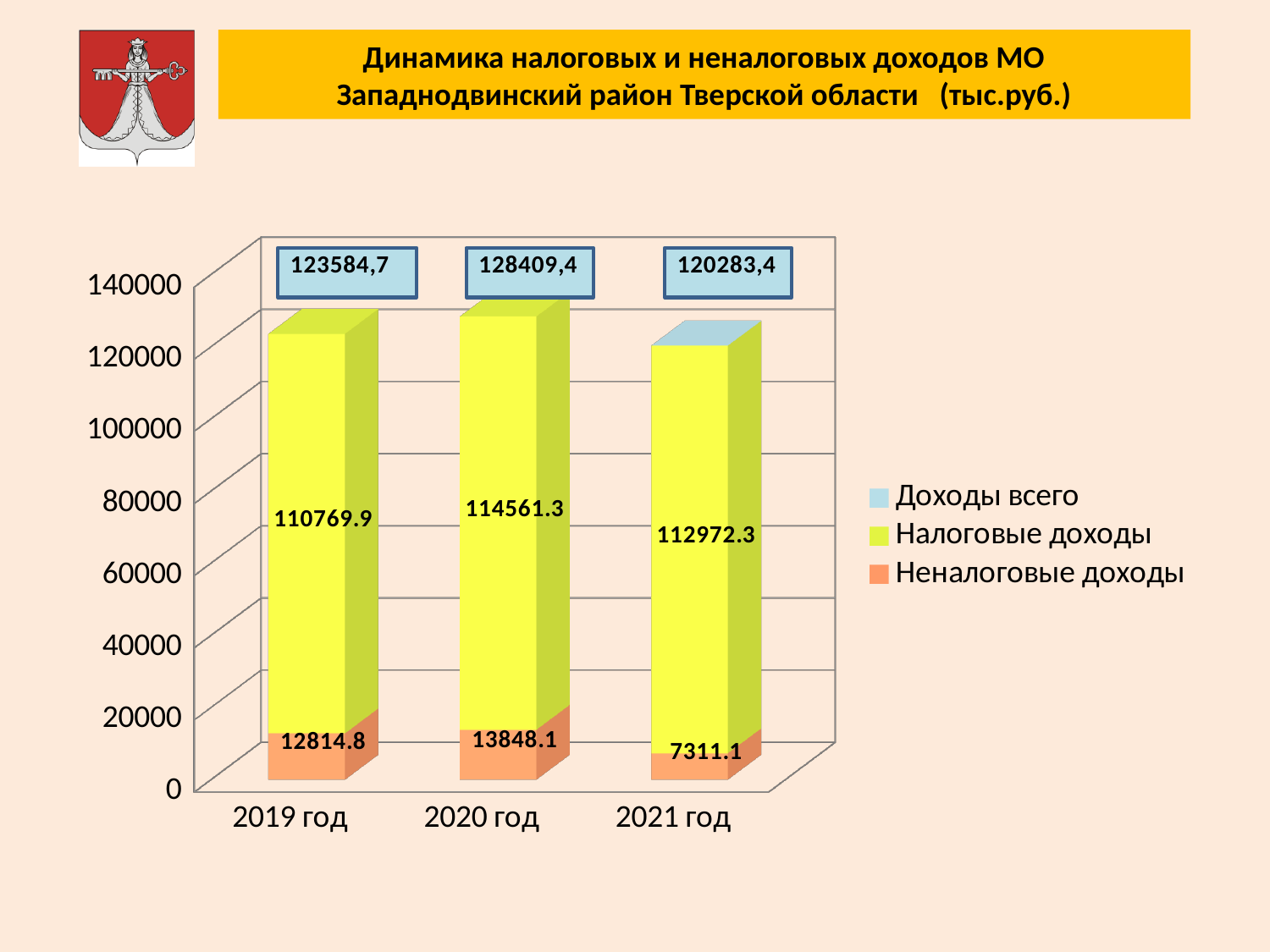
Which year has the lowest Неналоговые доходы? 2021 год What is the value of Налоговые доходы for 2020 год? 114561.3 What is the value of Неналоговые доходы for 2021 год? 7311.1 How many series does the legend list? 3 What kind of chart is shown on the slide? Stacked bar chart By how much did Неналоговые доходы fall from 2020 год to 2021 год? 6537.0 Which year has the highest Налоговые доходы? 2020 год How many years are shown on the x axis? 3 What total (Доходы всего) is shown in the box above the 2019 год bar? 123584,7 Which is larger: Неналоговые доходы in 2019 год or in 2020 год? 2020 год What is the difference between Налоговые доходы in 2020 год and 2019 год? 3791.4 Which year has the highest total income (Доходы всего)? 2020 год